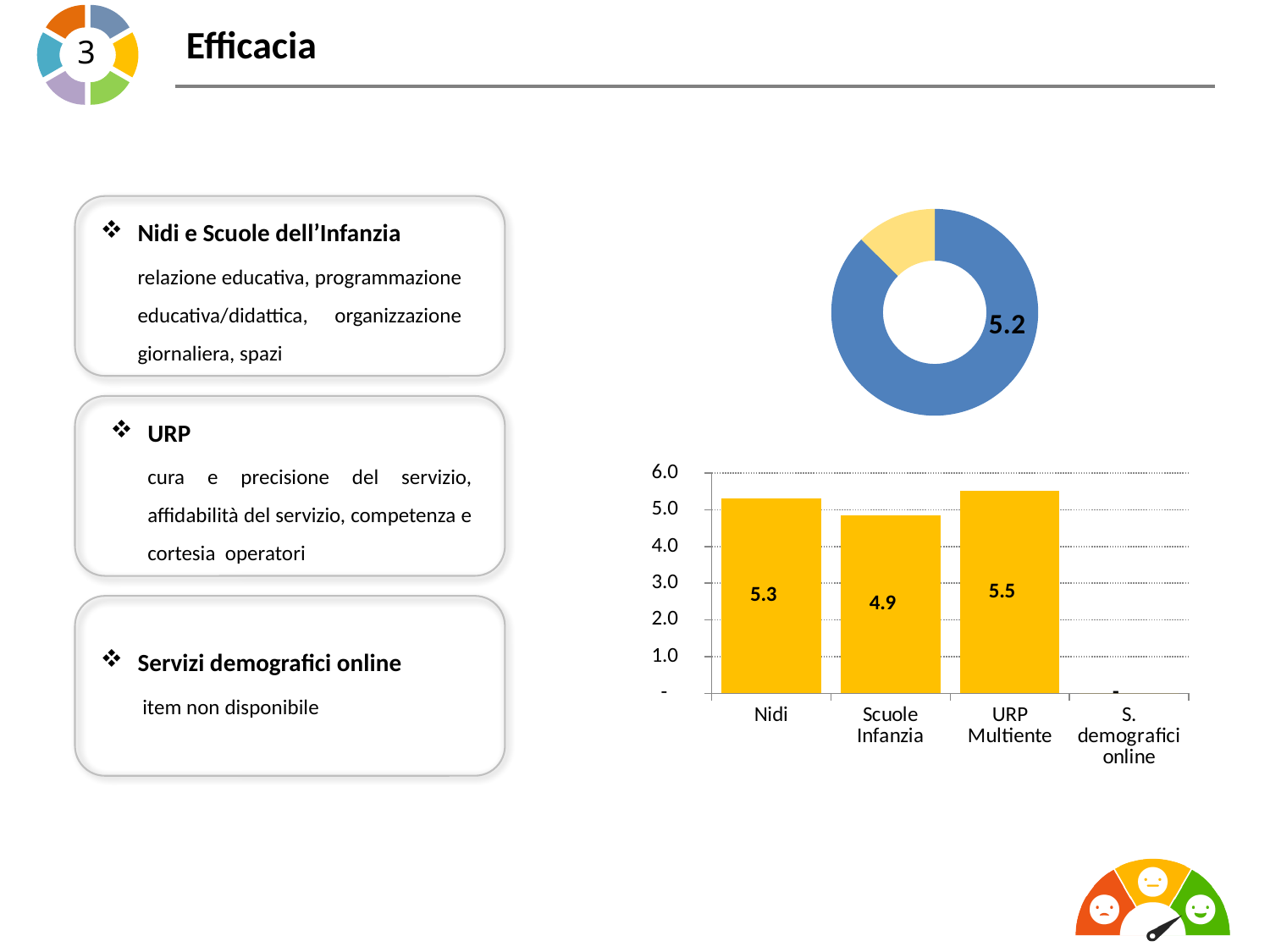
How many categories are shown on the x axis of the bar chart at the bottom right? 4 What value is printed in the centre of the doughnut chart at the top right? 5.2 In the bar chart at the bottom right, what is the value for URP Multiente? 5.5 In the bar chart at the bottom right, which category has no bar plotted (shown as '-')? S. demografici online In the bar chart at the bottom right, which of the three categories with a plotted bar has the lowest value? Scuole Infanzia In the bar chart at the bottom right, is the value for Scuole Infanzia greater or less than 5.0? less In the bar chart at the bottom right, what is the difference between the values for Nidi and Scuole Infanzia? 0.4 In the bar chart at the bottom right, what is the difference between the values for URP Multiente and Scuole Infanzia? 0.6 In the bar chart at the bottom right, which category has the highest value? URP Multiente In the bar chart at the bottom right, what is the value for Scuole Infanzia? 4.9 In the bar chart at the bottom right, which is larger, the value for Nidi or the value for Scuole Infanzia? Nidi In the bar chart at the bottom right, what is the value for Nidi? 5.3